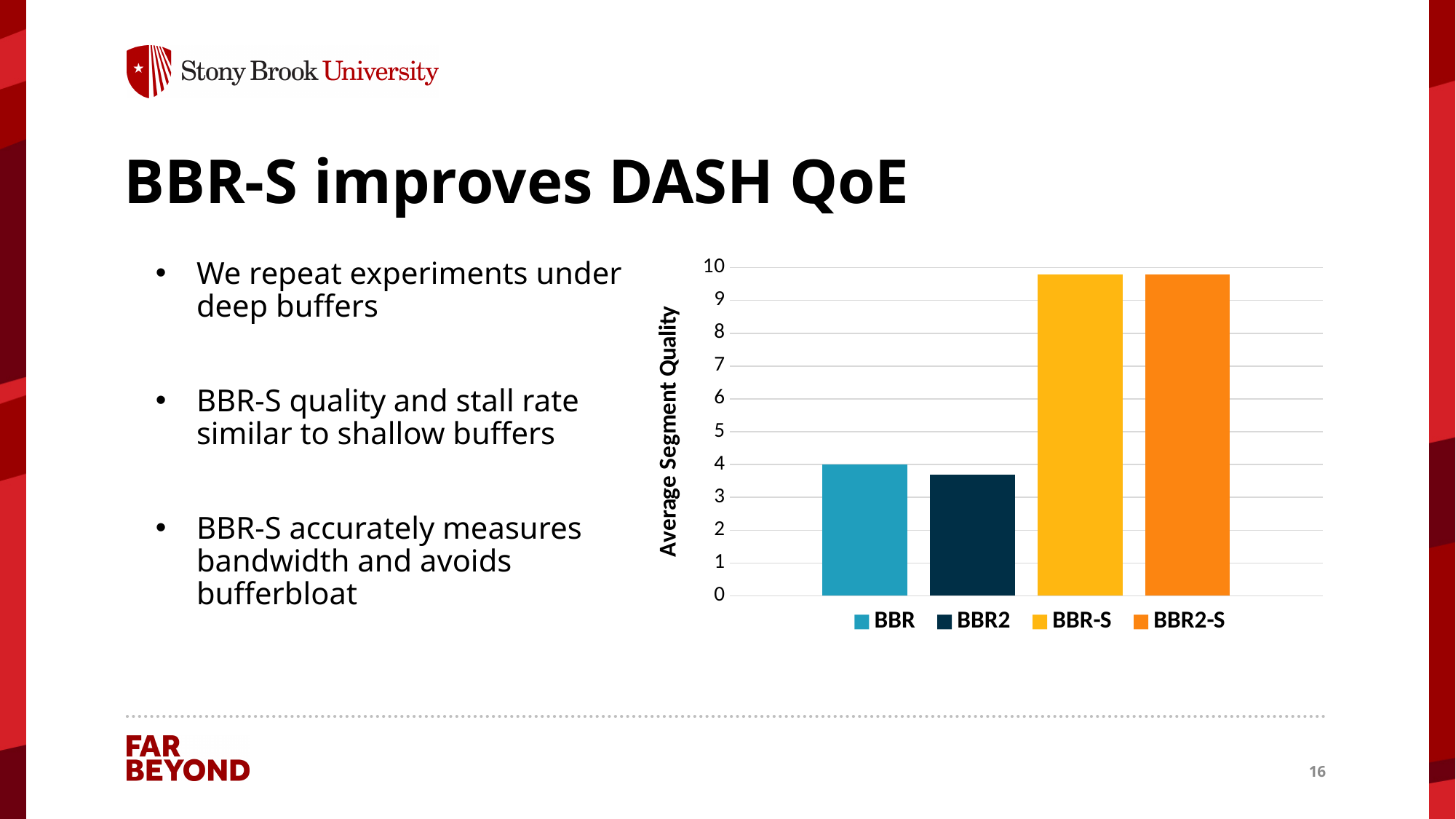
Which has the higher average segment quality, BBR-S or BBR? BBR-S Which has the higher average segment quality, BBR or BBR2? BBR Is the value for BBR2 greater or less than 5? less Is the value for BBR greater or less than 3? greater What colour is the BBR-S bar in the chart? yellow What is the label on the vertical axis of the chart? Average Segment Quality Is the value for BBR2-S greater or less than 8? greater How many series does the chart legend list? 4 What kind of chart is shown on the slide? bar chart How many bars are plotted in the chart? 4 Which series has the lowest average segment quality? BBR2